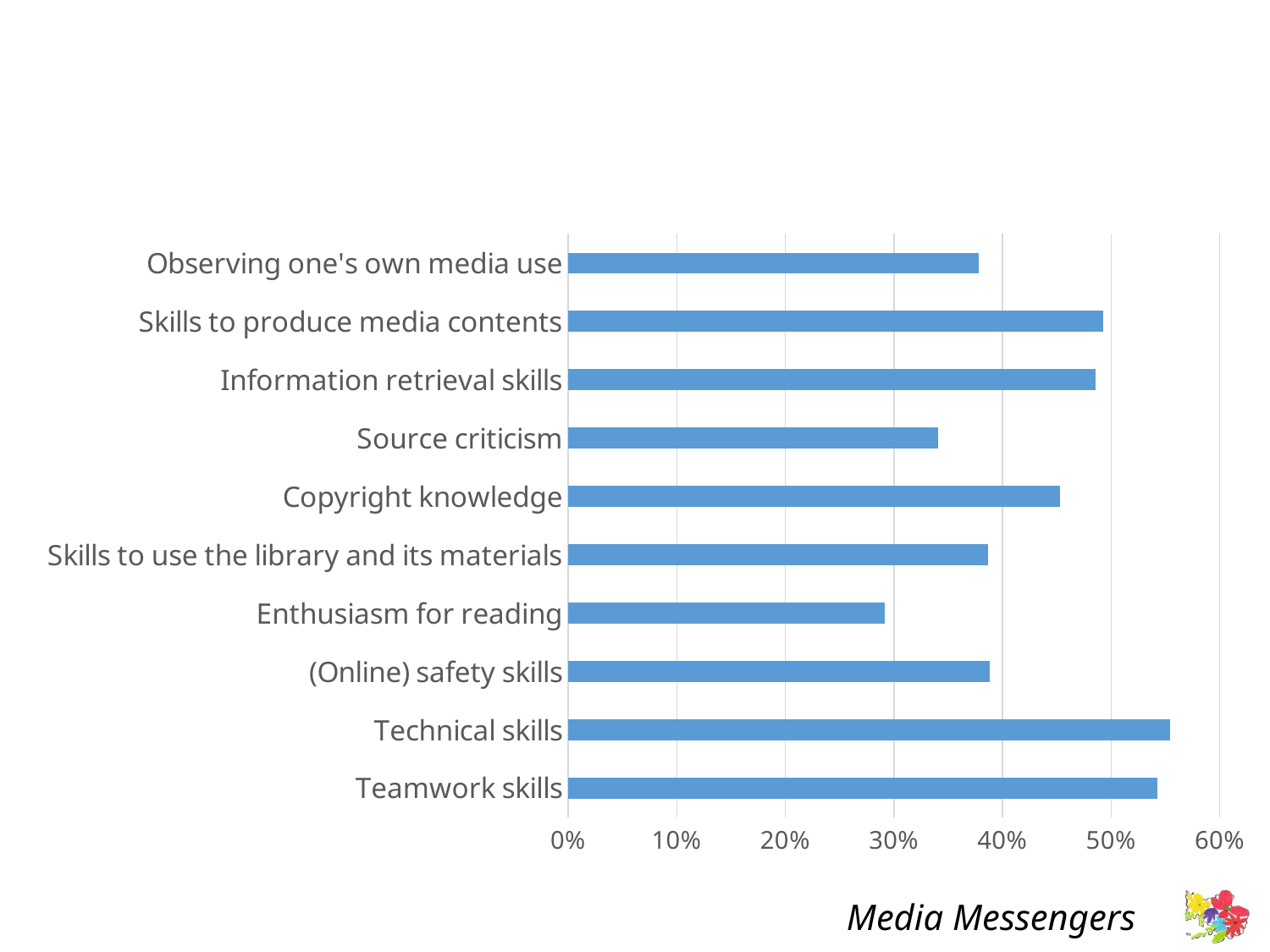
Is the value for Source criticism greater or less than 30%? greater What kind of chart is shown on the slide? bar chart Which is larger, the value for Source criticism or the value for Copyright knowledge? Copyright knowledge Which category has the lowest value in the chart? Enthusiasm for reading Is the value for Observing one's own media use greater or less than 40%? less Is the value for Information retrieval skills greater or less than 40%? greater Which is larger, the value for Enthusiasm for reading or the value for Observing one's own media use? Observing one's own media use How many categories are plotted in the chart? 10 What is the highest value shown on the horizontal axis of the chart? 60%